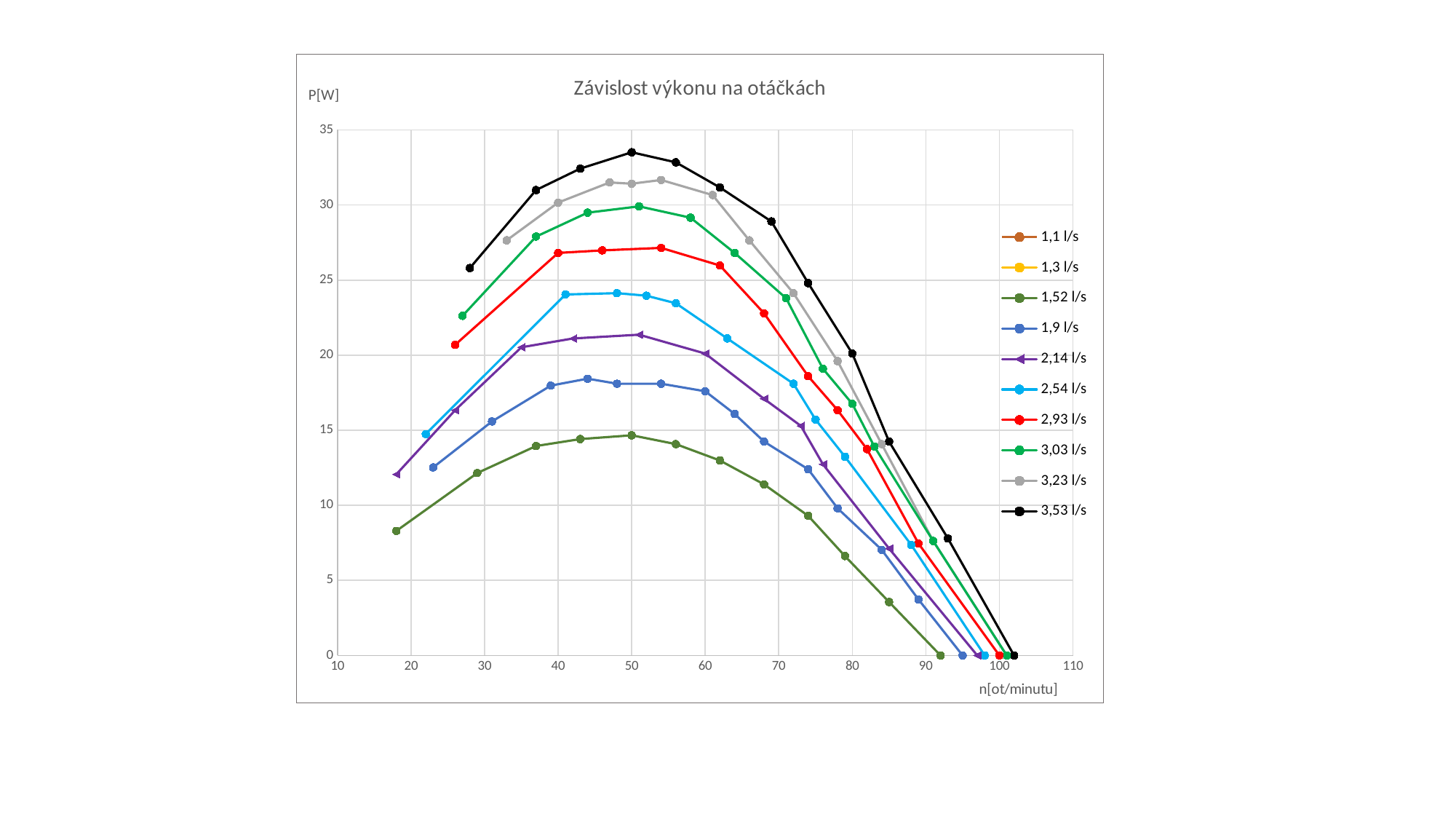
What kind of chart is shown on the slide? line chart Which plotted series has the lowest peak power value? 1,52 l/s Is the peak value of the 2,93 l/s series greater or less than 25? greater Is the peak value of the 1,9 l/s series greater or less than 20? less How many series does the legend list? 10 Is the peak value of the 3,53 l/s series greater or less than 30? greater Which series reaches the highest power value on the chart? 3,53 l/s How does the 3,53 l/s series change as n increases from 50 to 100 ot/minutu? falls At n = 50 ot/minutu, which series has the higher value: 3,03 l/s or 2,93 l/s? 3,03 l/s What is the title of the chart? Závislost výkonu na otáčkách What is the label of the x axis? n[ot/minutu]